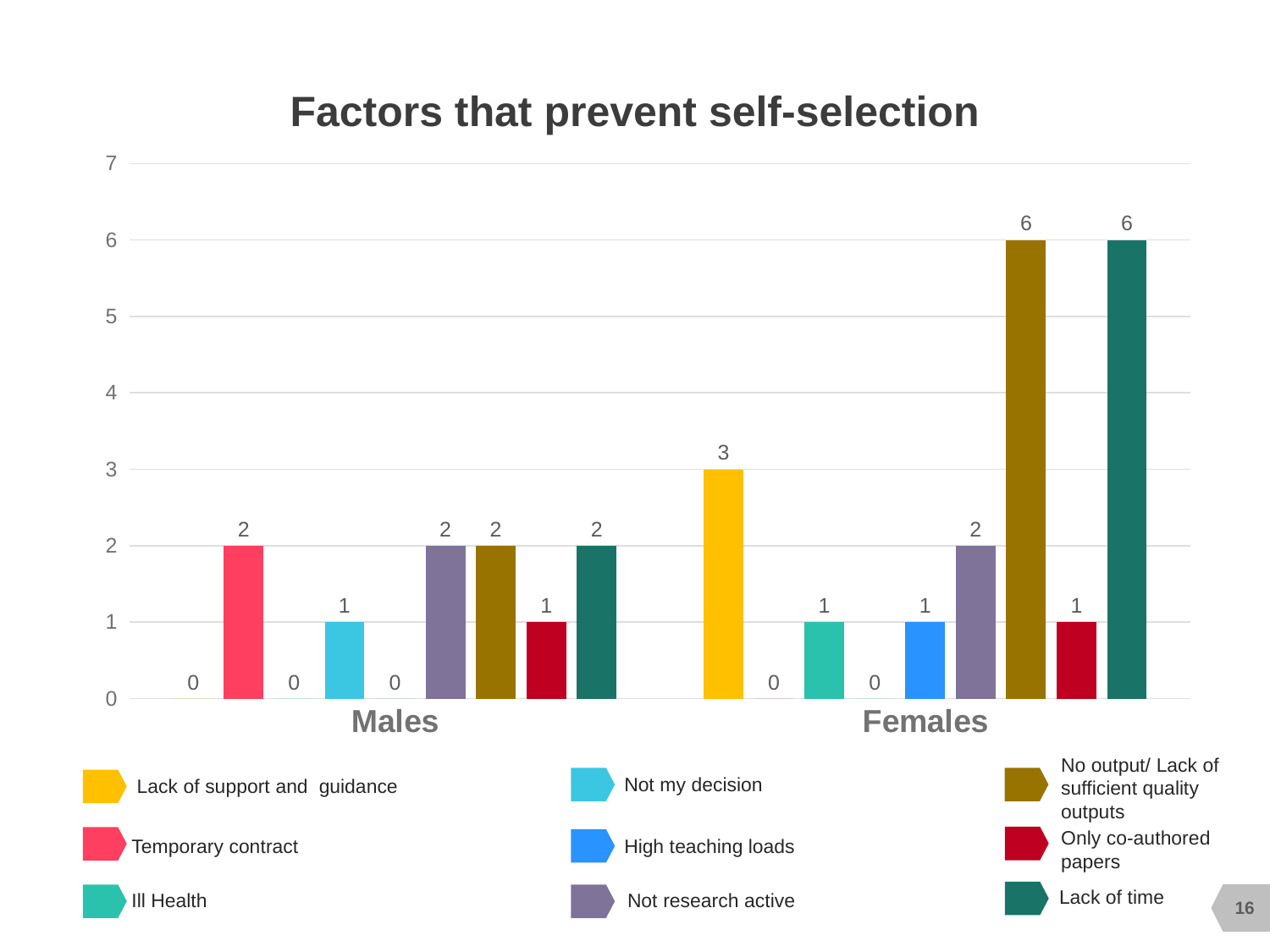
What is the value for High teaching loads for Females? 1 How many series does the legend list? 9 What is the value for Lack of time for Females? 6 What is the value for Lack of support and guidance for Females? 3 Which is larger: the Females value for Lack of support and guidance or the Males value for Lack of support and guidance? Females How many categories are shown on the x axis? 2 What is the difference between the Females and Males values for No output/ Lack of sufficient quality outputs? 4 What is the value for Not my decision for Males? 1 What is the value for Temporary contract for Males? 2 What kind of chart is shown on the slide? Bar chart Which factor has the highest value for Males? Temporary contract, Not research active, No output/ Lack of sufficient quality outputs and Lack of time (all 2) What is the title of the chart? Factors that prevent self-selection